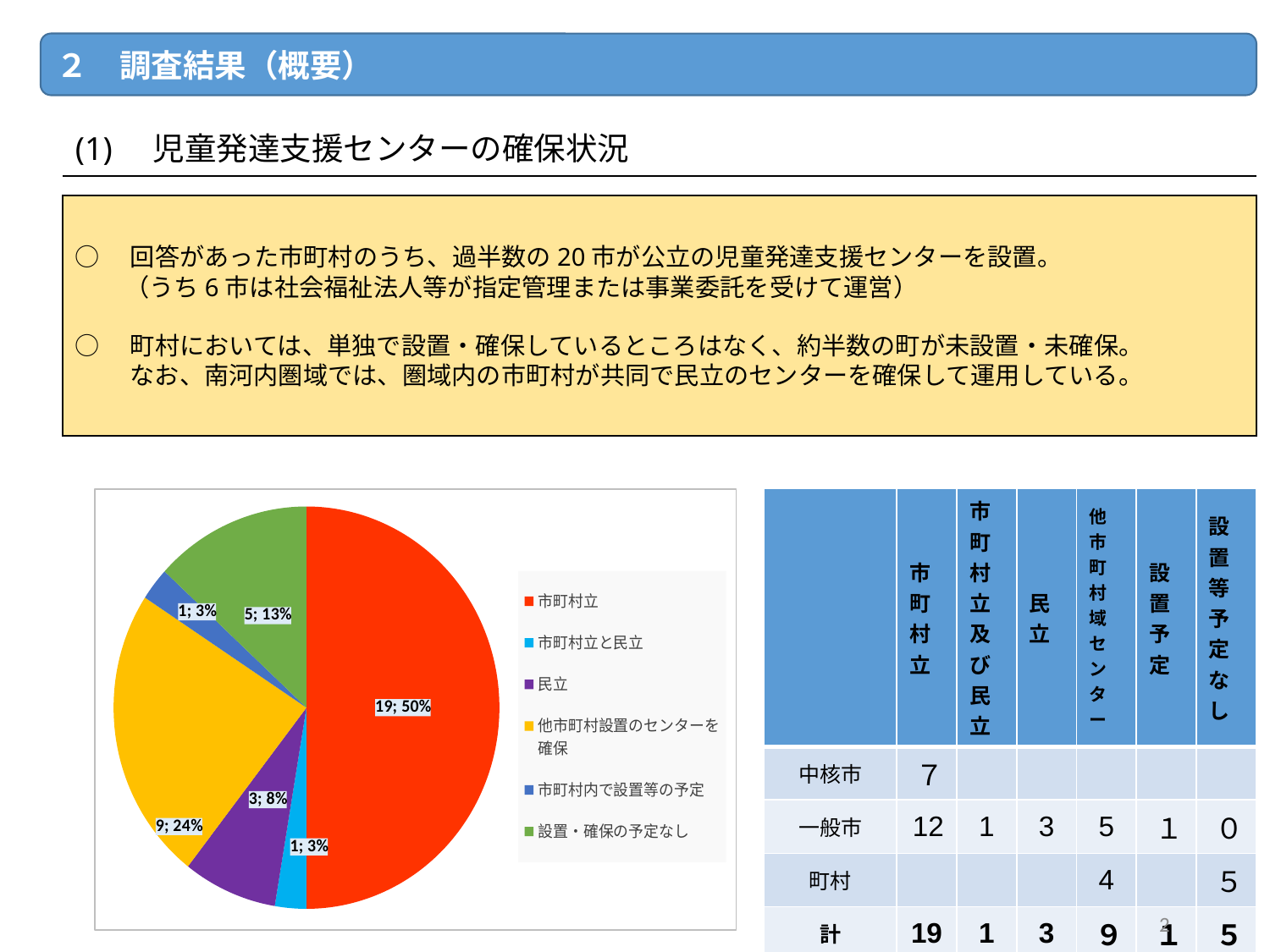
How many entries does the legend of the pie chart list? 6 What percentage share does the 設置・確保の予定なし slice have? 13% What is the count shown for the 他市町村設置のセンターを確保 slice? 9 Which is larger, the count for 民立 or the count for 設置・確保の予定なし? 設置・確保の予定なし What is the difference between the counts for 市町村立 and 他市町村設置のセンターを確保? 10 What kind of chart is shown on the slide? pie chart What is the count shown for the 市町村立 slice of the pie chart? 19 What percentage share does the 市町村立 slice have in the pie chart? 50% How many slices does the pie chart have? 6 Which category has the largest slice in the pie chart? 市町村立 What colour is the 市町村立 slice in the pie chart? red What is the count shown for the 民立 slice? 3